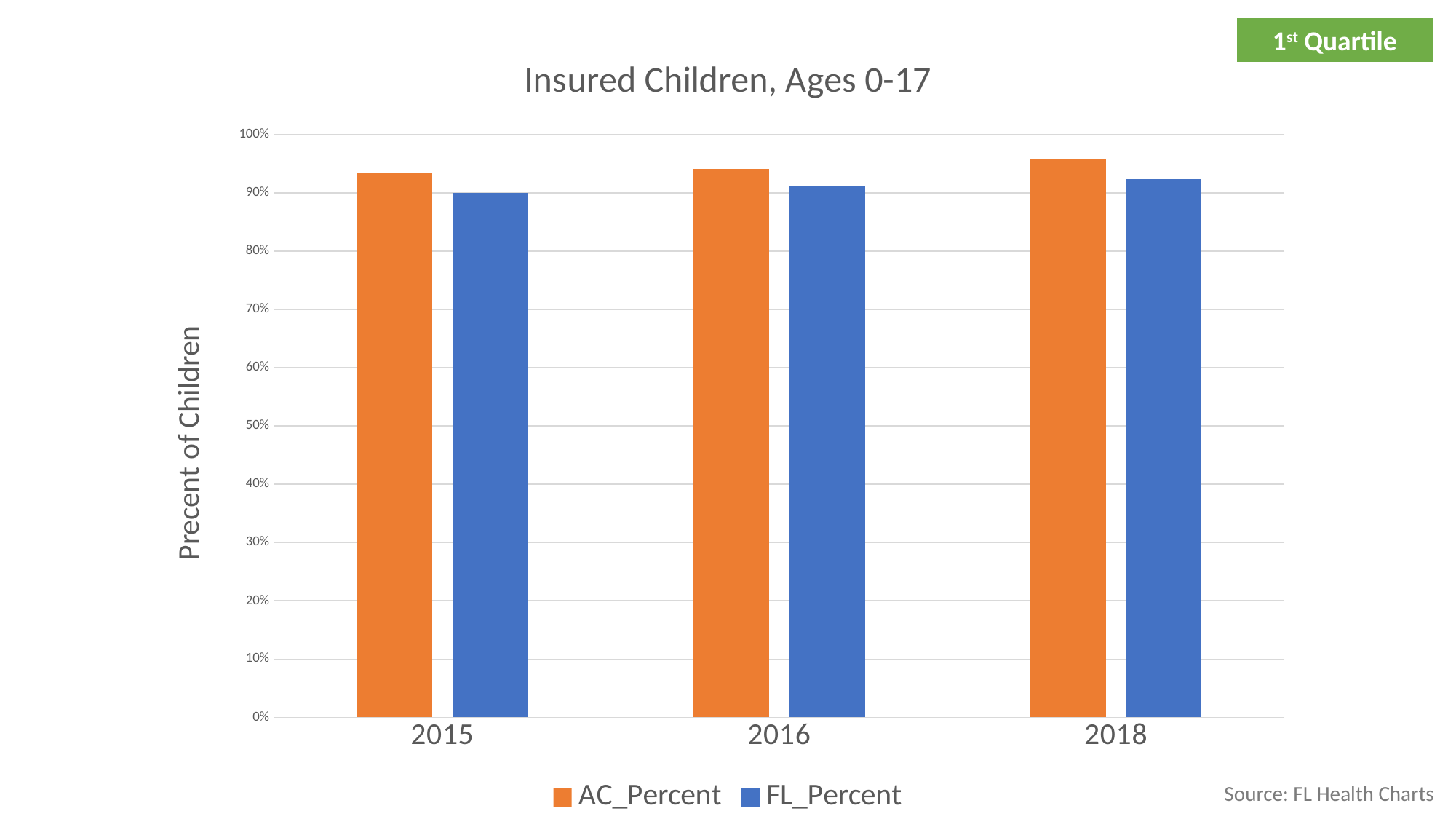
In 2015, which series has the larger value, AC_Percent or FL_Percent? AC_Percent In which year is the FL_Percent bar highest? 2018 Is the value for AC_Percent in 2015 greater or less than 90%? greater What is the label on the vertical axis of the chart? Precent of Children What is the title of the chart? Insured Children, Ages 0-17 Do the AC_Percent values rise or fall from 2015 to 2018? rise In 2018, which series has the larger value, AC_Percent or FL_Percent? AC_Percent How many years are shown on the x axis of the chart? 3 How many series does the chart's legend list? 2 In which year is the AC_Percent bar highest? 2018 Is the value for FL_Percent in 2018 greater or less than 90%? greater What kind of chart is shown on the slide? bar chart